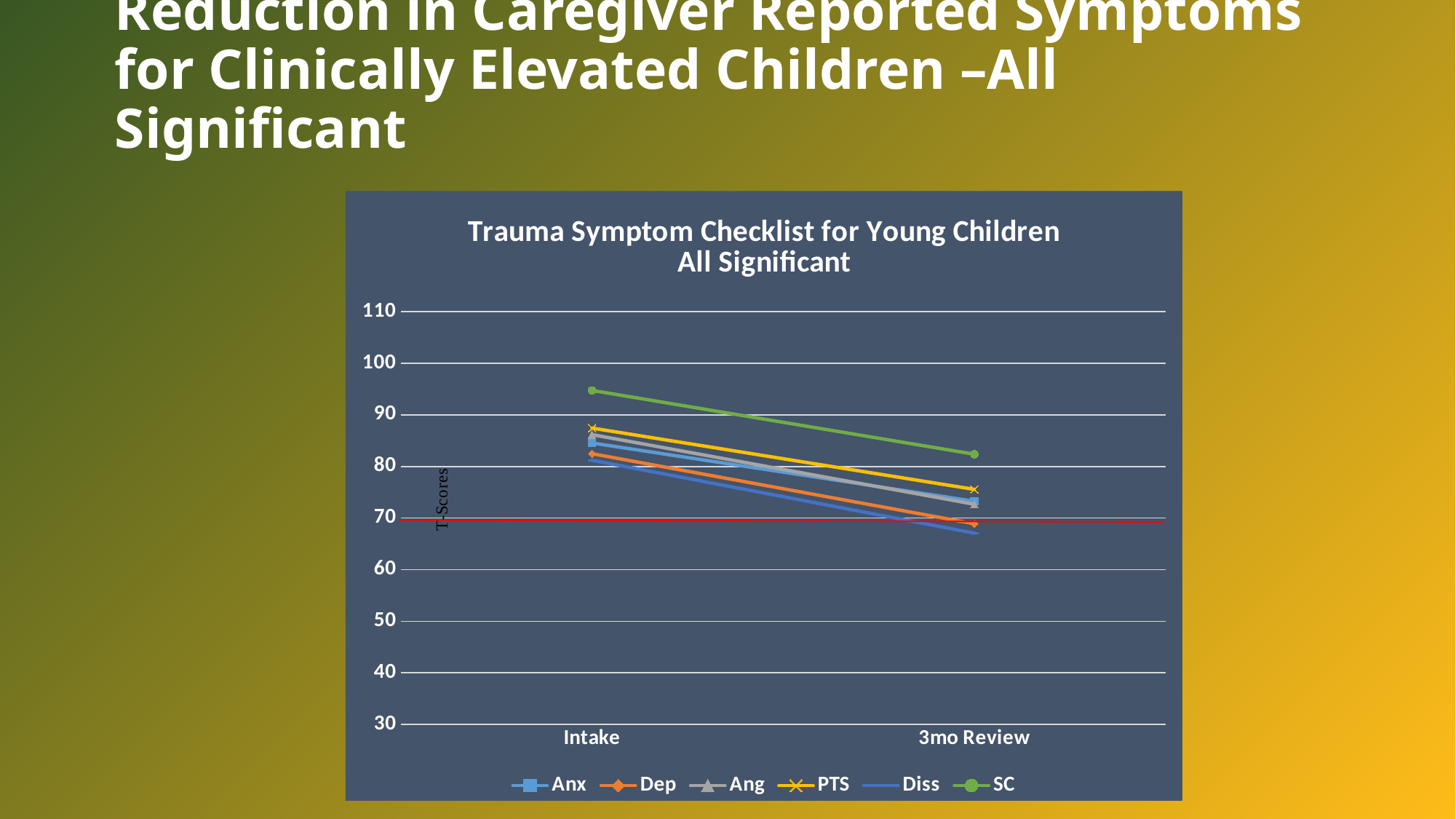
Do the values for the series rise or fall from Intake to 3mo Review? fall What is the title of the chart? Trauma Symptom Checklist for Young Children All Significant What kind of chart is shown on the slide? line chart Is the value for Diss at 3mo Review greater or less than 70? less Is the value for SC at Intake greater or less than 90? greater Which series has the highest value at 3mo Review? SC Is the value for PTS at Intake greater or less than 90? less How many time points are shown on the x axis? 2 Which is larger at Intake, the value for SC or the value for PTS? SC What is the label on the y axis? T-Scores How many series does the legend list? 6 Which series has the highest value at Intake? SC